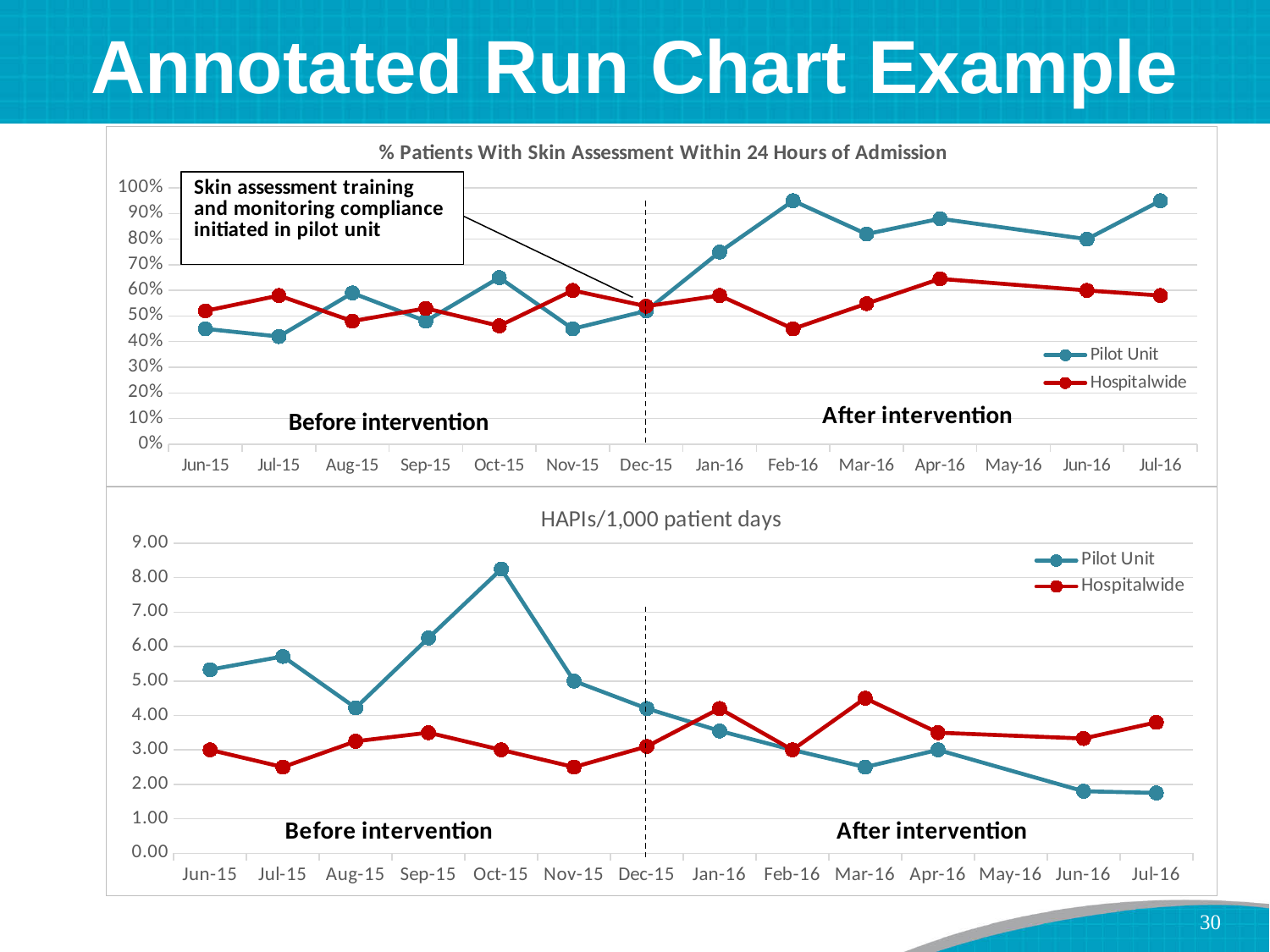
In the bottom chart, 'HAPIs/1,000 patient days', is the Pilot Unit value for Oct-15 greater or less than 8.00? greater In the bottom chart, 'HAPIs/1,000 patient days', does the Pilot Unit series generally rise or fall from Dec-15 to Jul-16? Fall In the bottom chart, 'HAPIs/1,000 patient days', in which month does the Hospitalwide series reach its highest value? Mar-16 How many months are shown on the x axis of the top chart, '% Patients With Skin Assessment Within 24 Hours of Admission'? 14 How many series does the legend of the bottom chart, 'HAPIs/1,000 patient days', list? 2 In the bottom chart, 'HAPIs/1,000 patient days', in which month does the Pilot Unit series reach its highest value? Oct-15 In the top chart, '% Patients With Skin Assessment Within 24 Hours of Admission', is the Hospitalwide value for Feb-16 greater or less than 50%? less In the bottom chart, 'HAPIs/1,000 patient days', which series is higher in Jul-16, Pilot Unit or Hospitalwide? Hospitalwide What kind of chart is the top chart, '% Patients With Skin Assessment Within 24 Hours of Admission'? Line chart In the top chart, '% Patients With Skin Assessment Within 24 Hours of Admission', is the Pilot Unit value for Feb-16 greater or less than 90%? greater In the top chart, '% Patients With Skin Assessment Within 24 Hours of Admission', which series is higher in Mar-16, Pilot Unit or Hospitalwide? Pilot Unit What does the annotation box in the top chart say was initiated in the pilot unit? Skin assessment training and monitoring compliance